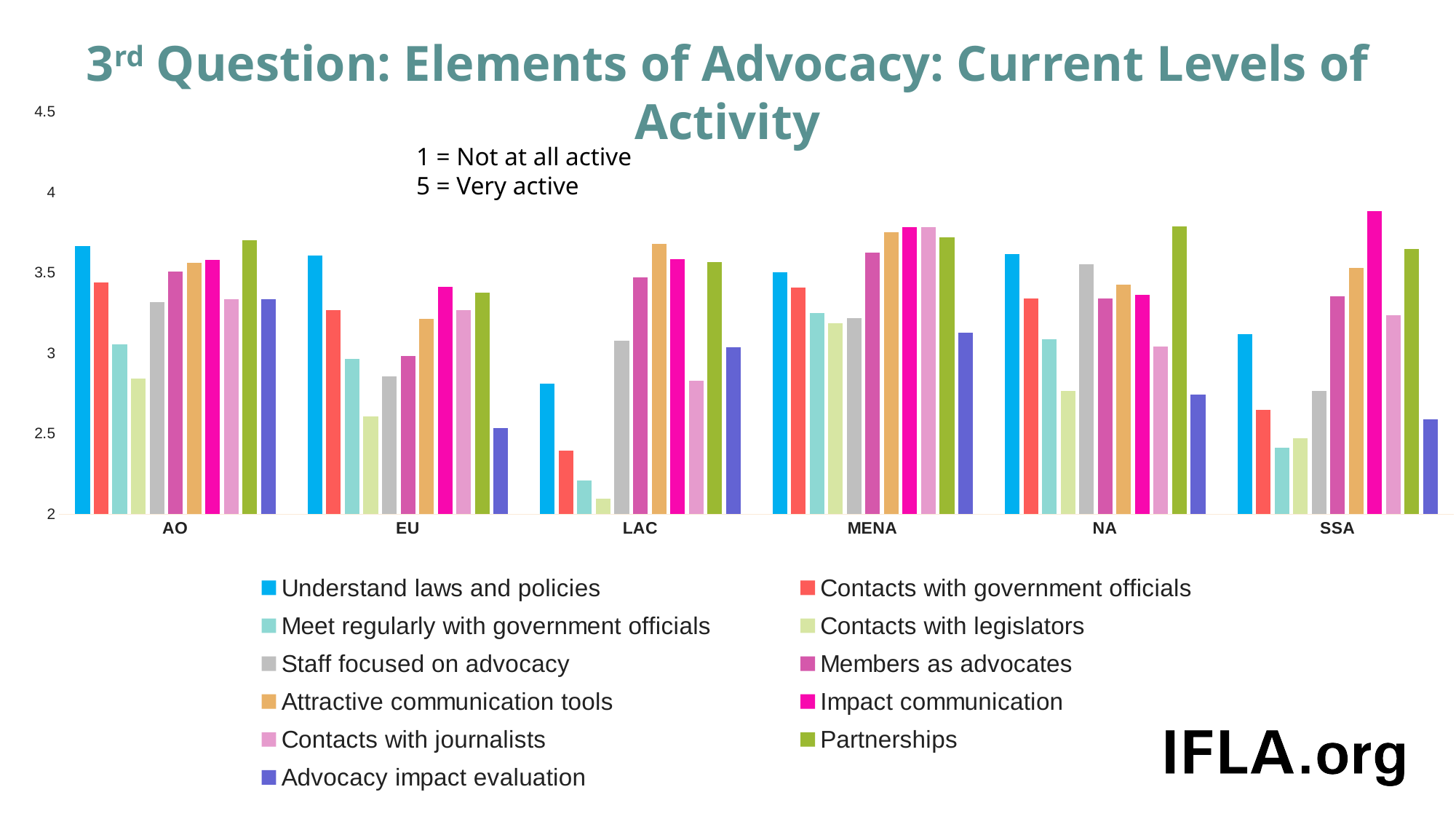
Is the value for Impact communication in SSA greater or less than 3.5? greater How many regions are shown along the x axis? 6 How many series does the legend list? 11 Is the value for Partnerships in NA greater or less than 3.5? greater Is the value for Understand laws and policies in LAC greater or less than 3? less Is the value for Understand laws and policies larger in AO or in LAC? AO According to the note on the slide, what does a score of 5 mean? Very active Which series has the lowest value in AO? Contacts with legislators Which series has the lowest value in LAC? Contacts with legislators What kind of chart is shown on the slide? bar chart Which series has the highest value in SSA? Impact communication